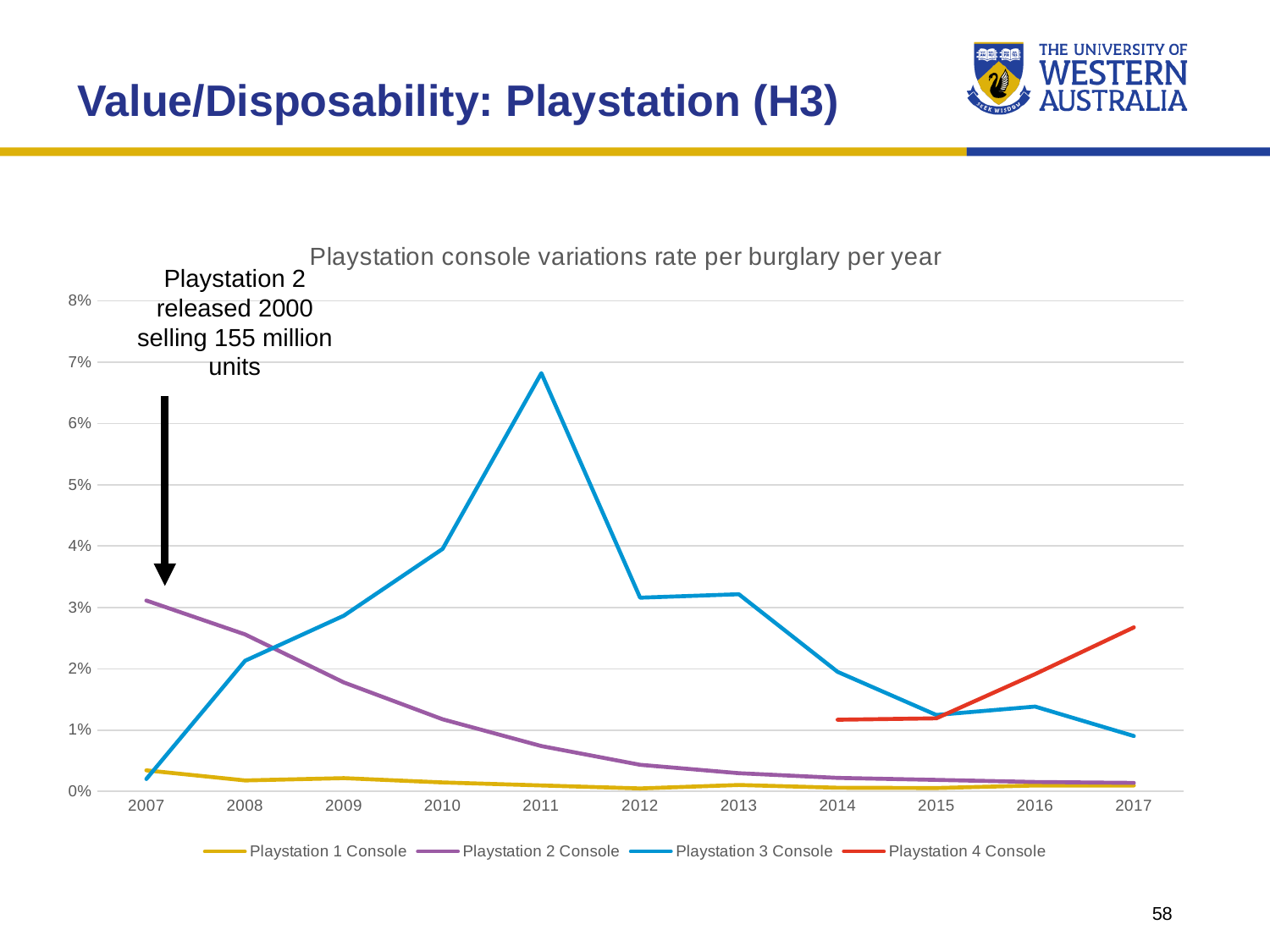
Is the value for Playstation 3 Console in 2011 greater or less than 6%? greater How many series does the legend list? 4 Does the Playstation 2 Console line rise or fall from 2007 to 2017? fall Does the Playstation 4 Console line rise or fall from 2014 to 2017? rise How many years are shown along the x axis? 11 Which series has the lowest value in 2011? Playstation 1 Console In which year does the Playstation 3 Console line reach its highest value? 2011 Is the value for Playstation 3 Console in 2012 greater or less than 4%? less Is the value for Playstation 2 Console in 2007 greater or less than 2%? greater In 2017, which is larger: Playstation 4 Console or Playstation 3 Console? Playstation 4 Console What is the title of the chart? Playstation console variations rate per burglary per year What kind of chart is shown on the slide? line chart